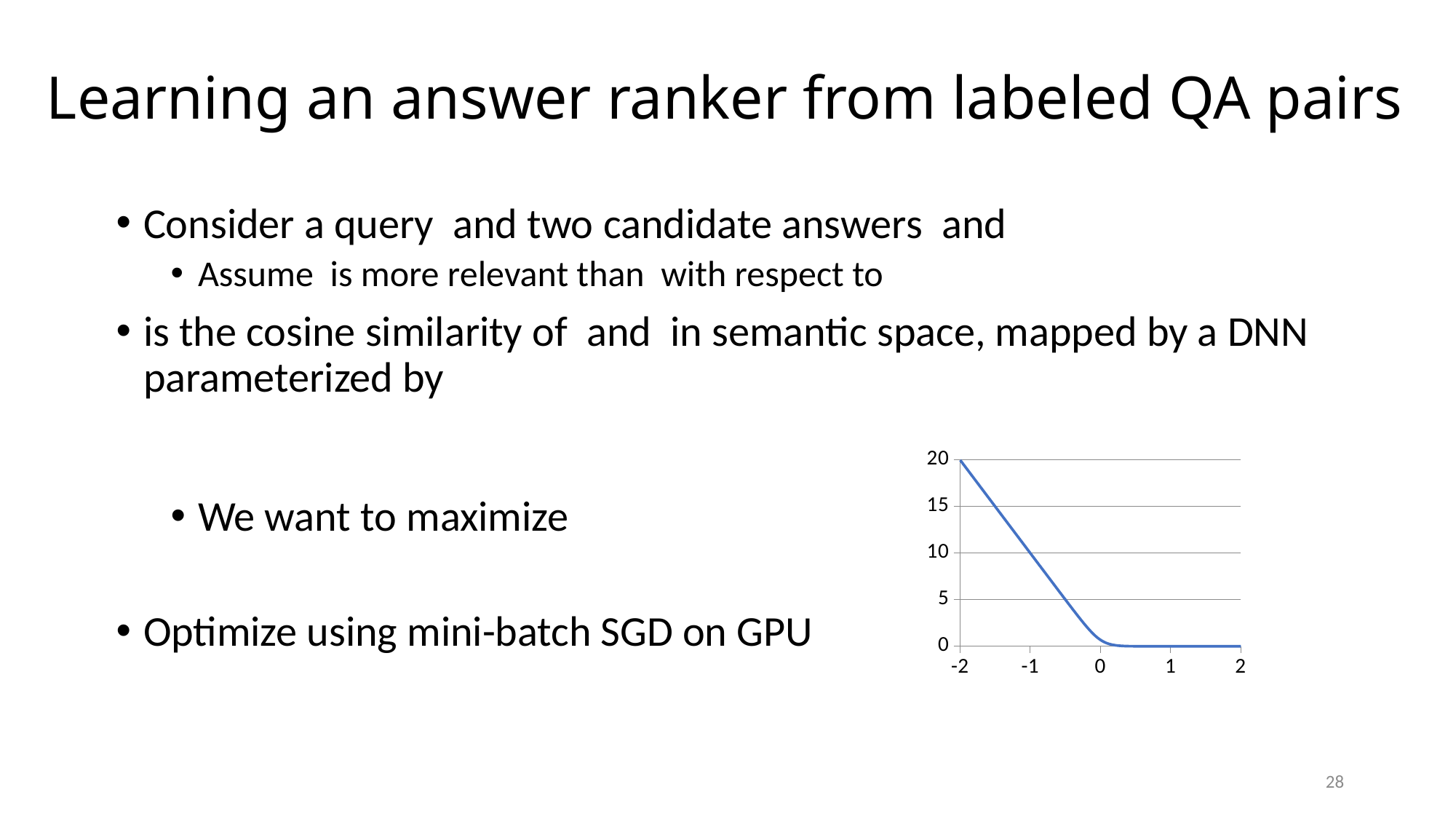
Is the value of the line larger at x = -1 or at x = 1? x = -1 What kind of chart is shown on the slide? line chart What is the value of the line at x = -2? 20 Is the value of the line at x = -1 greater or less than 5? greater What is the value of the line at x = 2? 0 Is the value of the line at x = -2 greater or less than 15? greater Is the value of the line at x = 1 greater or less than 5? less At which labeled x value is the line highest? -2 Do the values on the chart rise or fall as x increases from -2 to 0? fall How many tick labels are shown on the x axis of the chart? 5 What is the highest value labeled on the y axis of the chart? 20